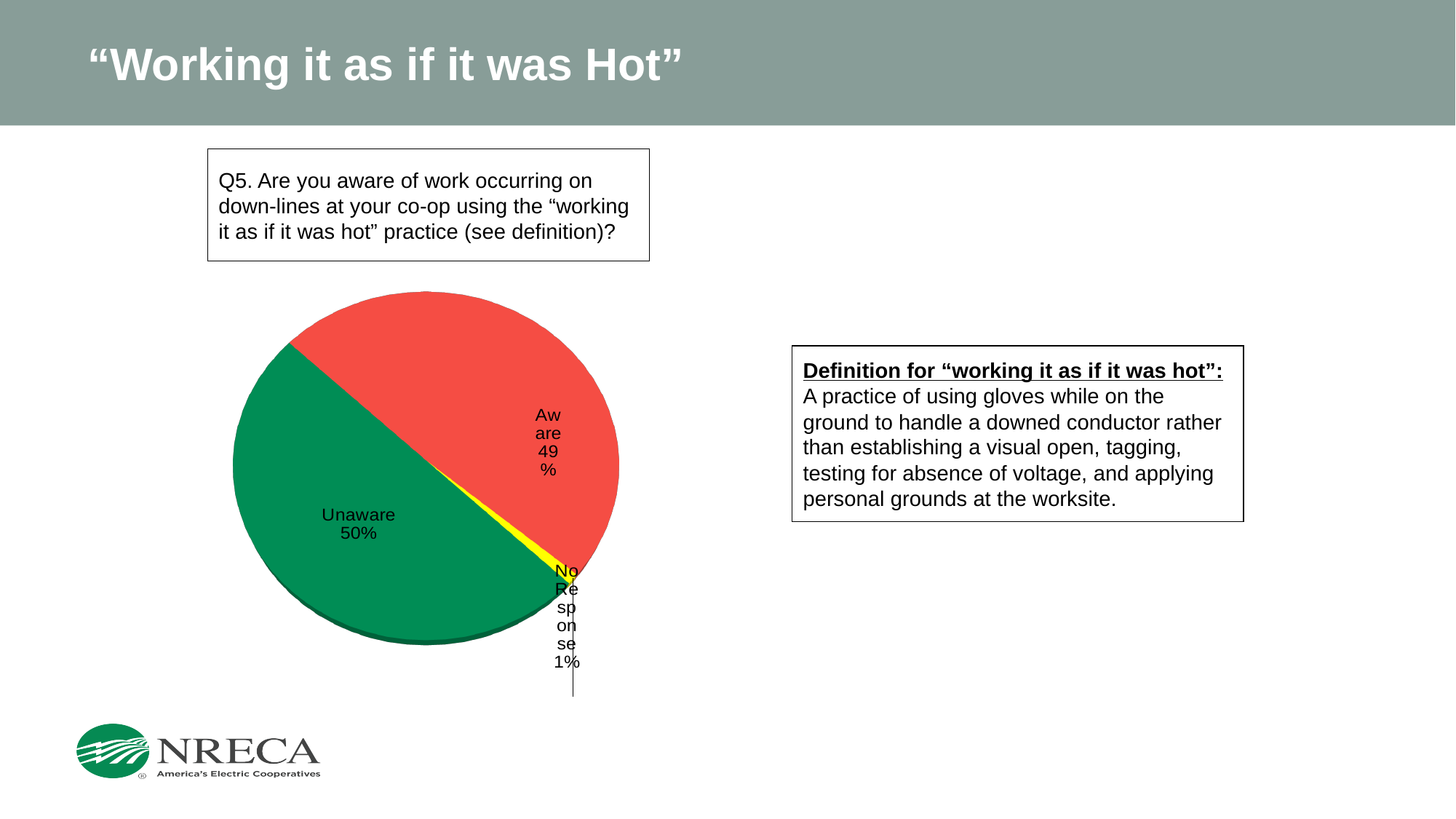
What percentage of the pie chart is labelled No Response? 1% Which is larger, the Aware slice or the No Response slice? Aware What colour is the No Response slice of the pie chart? Yellow What is the difference in percentage points between the Unaware and Aware slices? 1% What percentage of the pie chart is labelled Aware? 49% What percentage of the pie chart is labelled Unaware? 50% What kind of chart is shown on the slide? Pie chart What is the difference in percentage points between the Aware and No Response slices? 48% Which slice of the pie chart is the smallest? No Response Which slice of the pie chart is the largest? Unaware How many slices does the pie chart have? 3 What colour is the Unaware slice of the pie chart? Green